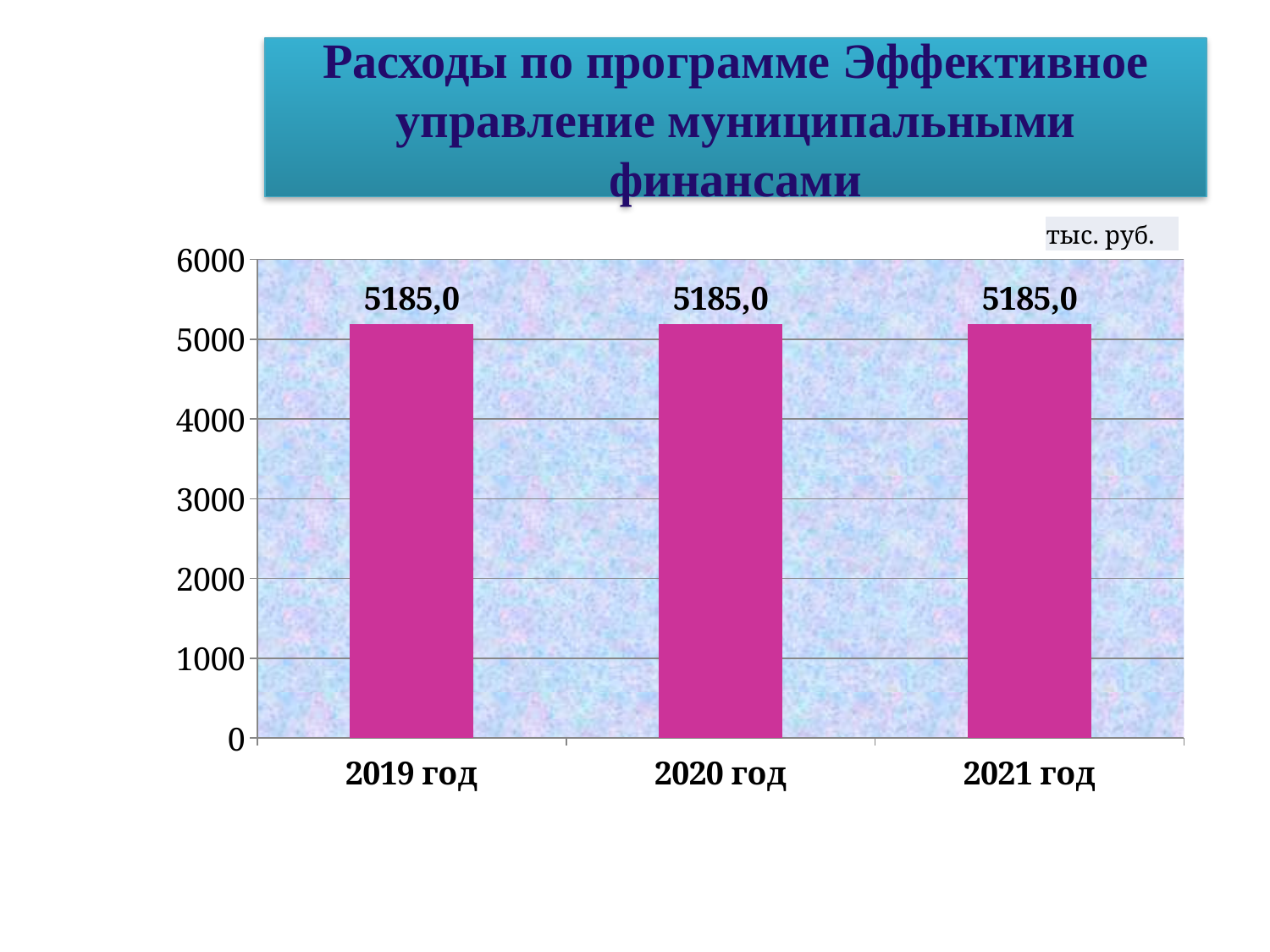
What is the difference between the values for 2021 год and 2019 год? 0,0 What kind of chart is shown on the slide? bar chart What is the value for 2019 год? 5185,0 How many categories (years) are shown on the x axis? 3 Is the value for 2019 год greater or less than 6000? less What unit of measurement is indicated above the chart? тыс. руб. Do the values rise, fall, or stay the same from 2019 год to 2021 год? stay the same What is the value for 2020 год? 5185,0 What is the value for 2021 год? 5185,0 What is the title of the chart? Расходы по программе Эффективное управление муниципальными финансами Is the value for 2020 год greater or less than 5000? greater